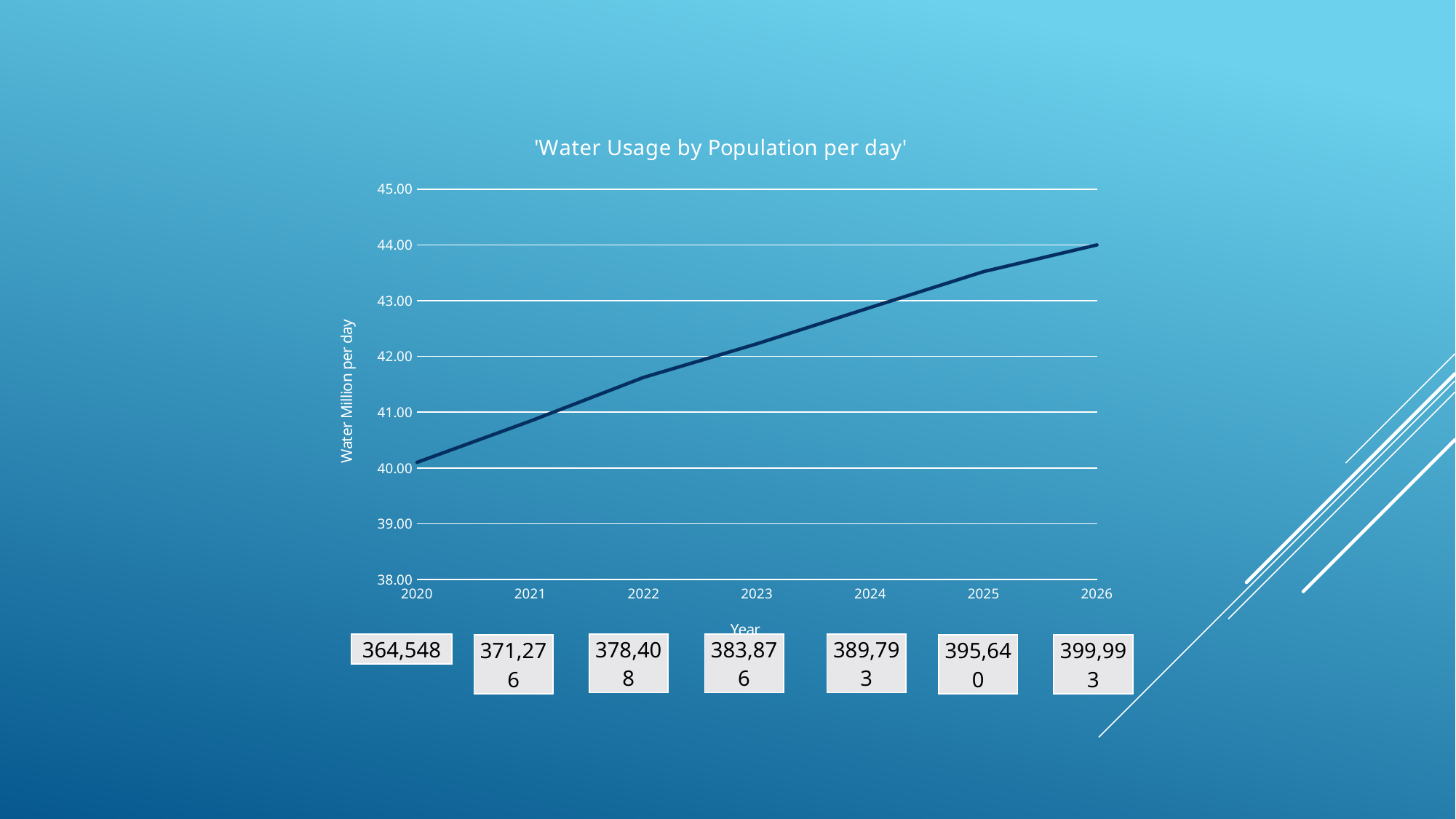
Which year has the highest water usage on the chart? 2026 What is the label on the vertical axis of the chart? Water Million per day Which year has the larger water usage, 2021 or 2023? 2023 How many years are plotted along the x axis of the chart? 7 Is the value for 2025 greater or less than 43.00? greater Which year has the lowest water usage on the chart? 2020 What kind of chart is shown on the slide? line chart What is the title of the chart? 'Water Usage by Population per day' Does the water usage rise or fall from 2020 to 2026? rise Is the value for 2020 greater or less than 41.00? less Is the value for 2022 greater or less than 41.00? greater